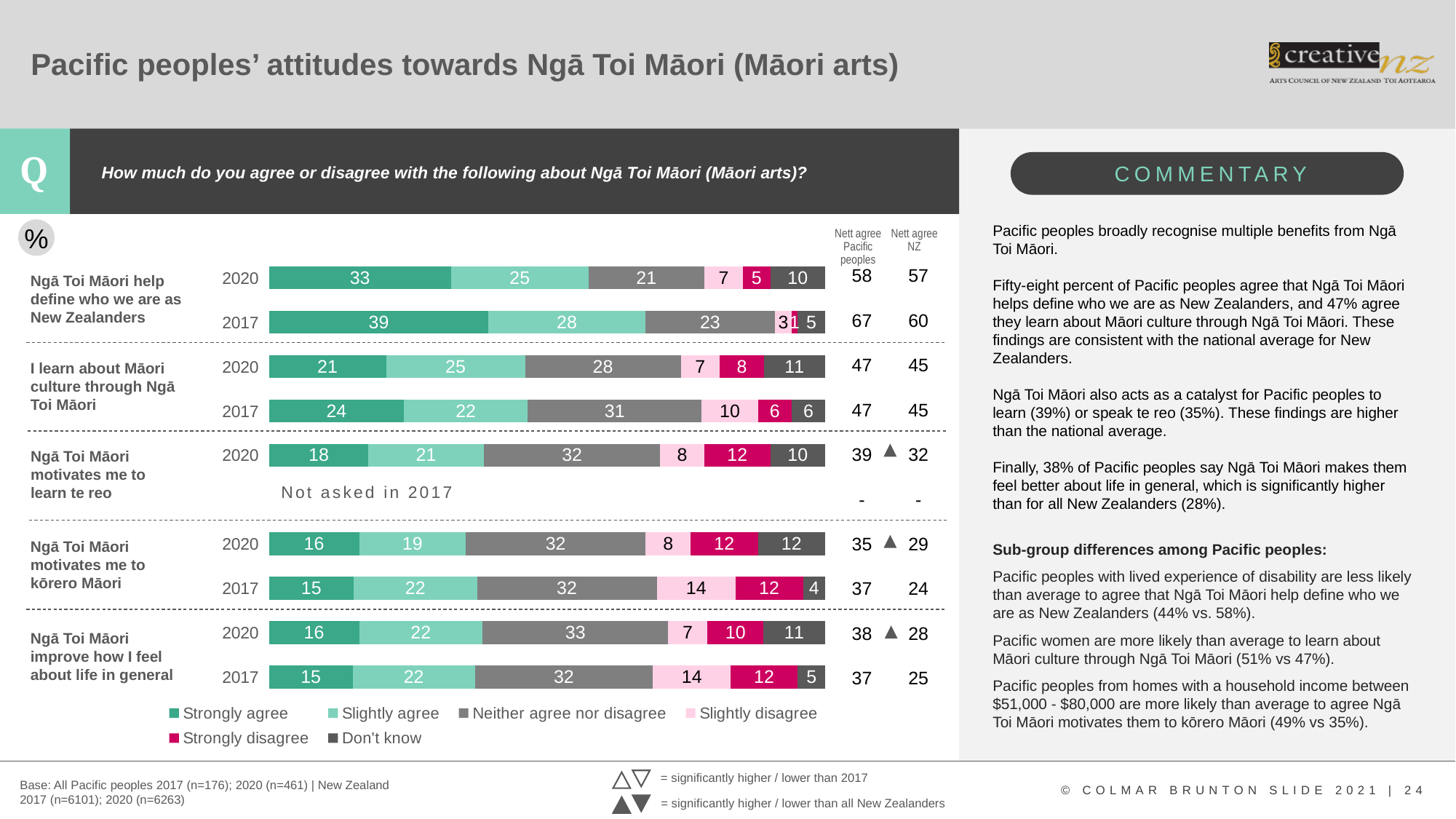
Which statement was not asked in 2017? Ngā Toi Māori motivates me to learn te reo What is the 'Strongly disagree' value for 'Ngā Toi Māori motivates me to learn te reo' in 2020? 12 What kind of chart is shown on the slide? Stacked bar chart What is the difference between the 'Strongly agree' values for 'Ngā Toi Māori help define who we are as New Zealanders' in 2017 and 2020? 6 How many series does the legend list? 6 What is the 'Neither agree nor disagree' value for 'I learn about Māori culture through Ngā Toi Māori' in 2017? 31 How many statements are listed on the chart? 5 What is the Nett agree NZ figure for 'I learn about Māori culture through Ngā Toi Māori' in 2020? 45 Which statement has the highest 'Strongly agree' value in 2020? Ngā Toi Māori help define who we are as New Zealanders What is the 'Strongly agree' value for 'Ngā Toi Māori help define who we are as New Zealanders' in 2020? 33 What is the Nett agree Pacific peoples figure for 'Ngā Toi Māori improve how I feel about life in general' in 2020? 38 Which is larger: the 'Slightly disagree' value for 'Ngā Toi Māori motivates me to kōrero Māori' in 2017 or in 2020? 2017